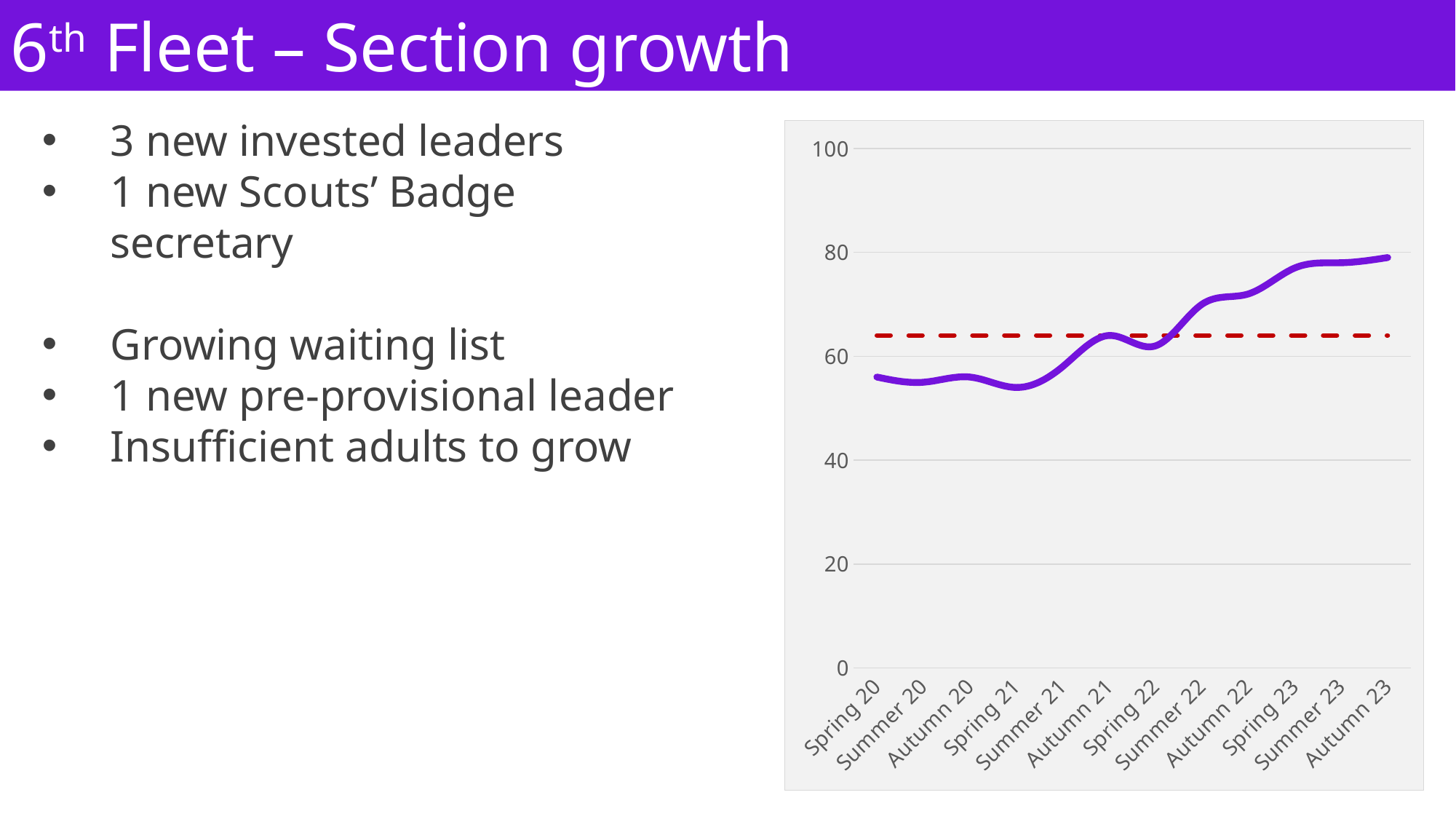
Which is larger, the value for Spring 21 or the value for Autumn 22? Autumn 22 Is the value for Autumn 22 greater or less than 60? greater Which is larger, the value for Autumn 23 or the value for Spring 20? Autumn 23 Is the value for Spring 20 greater or less than 40? greater What kind of chart is shown on the slide? line chart What is the first period label on the x axis of the chart? Spring 20 Is the value for Spring 21 greater or less than 60? less Which period has the highest value on the chart? Autumn 23 How many time periods are plotted along the x axis of the chart? 12 What colour is the solid data line on the chart? purple Do the values on the chart generally rise or fall from Spring 20 to Autumn 23? rise